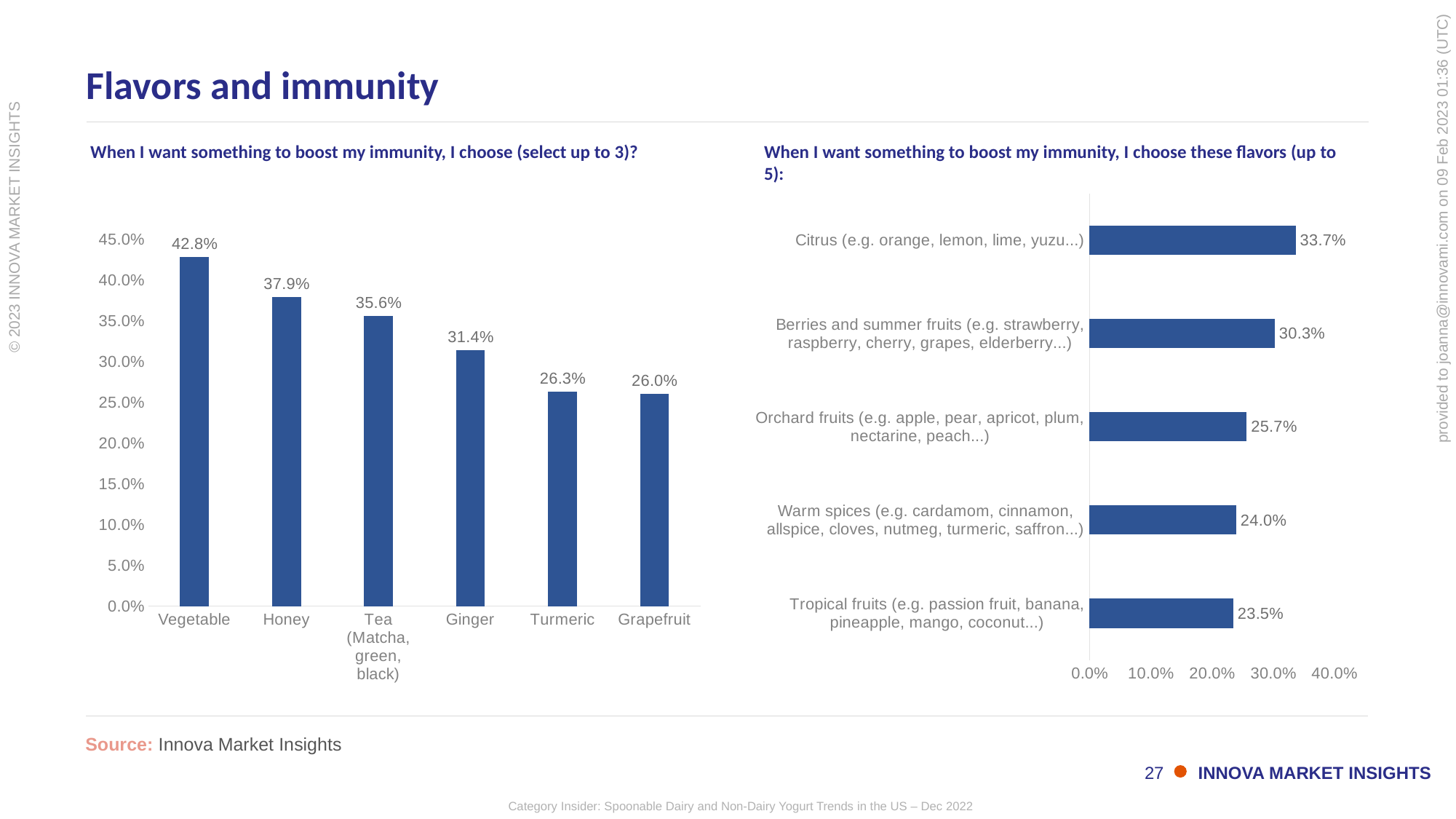
In the right chart (flavors, up to 5), which flavor category has the highest value? Citrus (e.g. orange, lemon, lime, yuzu...) In the left chart (select up to 3), what is the difference between Vegetable and Ginger? 11.4% In the right chart (flavors, up to 5), what is the value for Orchard fruits? 25.7% In the left chart (select up to 3), which category has the highest value? Vegetable In the right chart (flavors, up to 5), which flavor category has the lowest value? Tropical fruits (e.g. passion fruit, banana, pineapple, mango, coconut...) In the right chart (flavors, up to 5), what is the difference between Citrus and Berries and summer fruits? 3.4% In the left chart (select up to 3), how many categories are shown? 6 In the left chart (select up to 3), which category has the lowest value? Grapefruit In the left chart (select up to 3), do the values rise or fall from left to right? fall What type of chart is the right chart (flavors, up to 5)? bar chart In the left chart (select up to 3), what is the value for Honey? 37.9% In the right chart (flavors, up to 5), which is larger: Berries and summer fruits or Warm spices? Berries and summer fruits